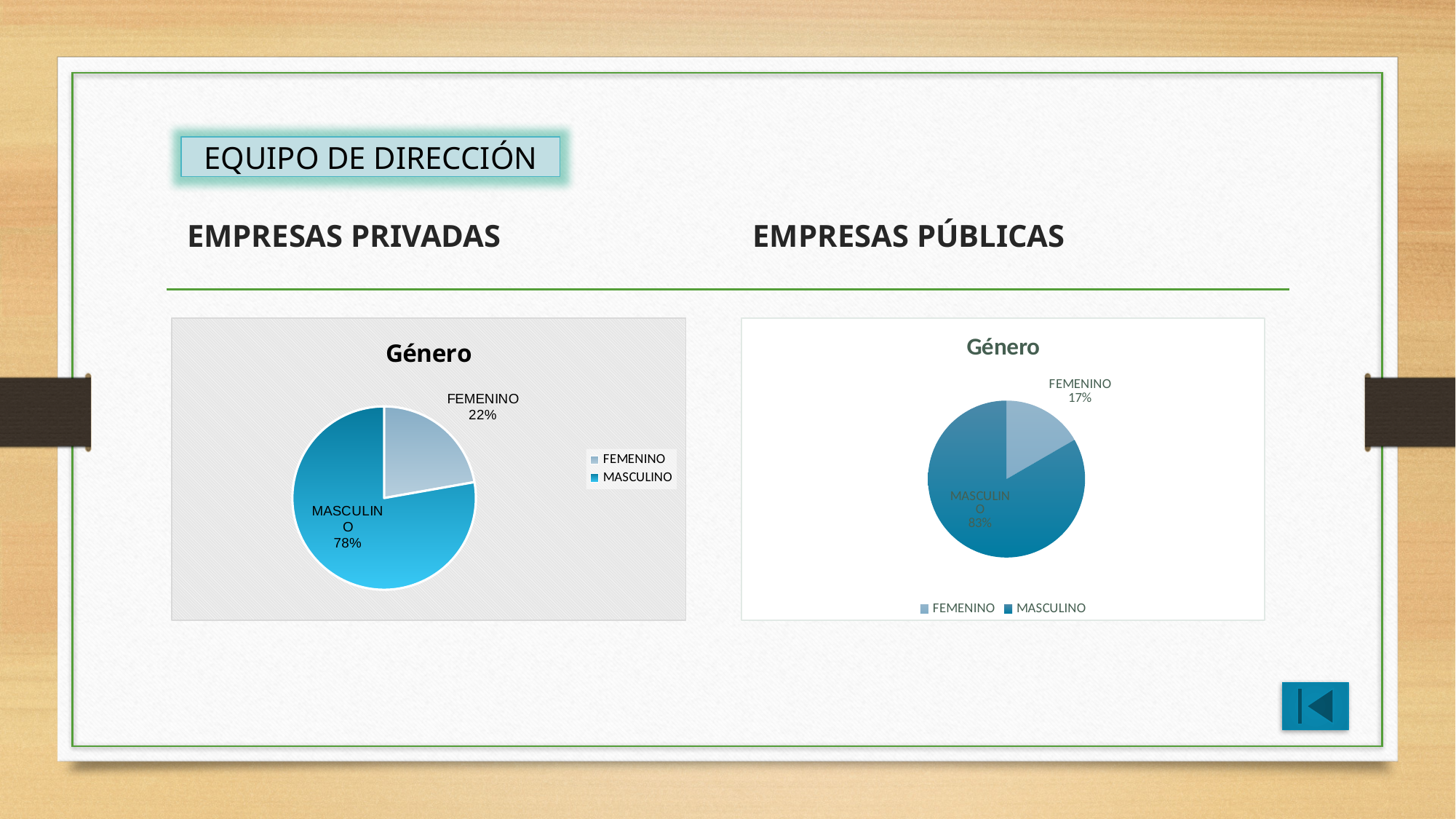
In the Género pie chart under EMPRESAS PRIVADAS, what is the difference between the MASCULINO and FEMENINO shares? 56% How many entries does the legend of the Género chart under EMPRESAS PÚBLICAS list? 2 In the Género pie chart under EMPRESAS PRIVADAS, which category has the largest slice? MASCULINO In the Género pie chart under EMPRESAS PÚBLICAS, which category has the smallest slice? FEMENINO In the Género pie chart under EMPRESAS PRIVADAS, what share is MASCULINO? 78% How many slices does the Género pie chart under EMPRESAS PRIVADAS have? 2 In the Género pie chart under EMPRESAS PRIVADAS, what share is FEMENINO? 22% In the Género pie chart under EMPRESAS PÚBLICAS, what share is MASCULINO? 83% What is the title of the pie chart under EMPRESAS PRIVADAS? Género What type of chart is shown under EMPRESAS PÚBLICAS? Pie chart Is the FEMENINO share larger in the EMPRESAS PRIVADAS chart or in the EMPRESAS PÚBLICAS chart? EMPRESAS PRIVADAS